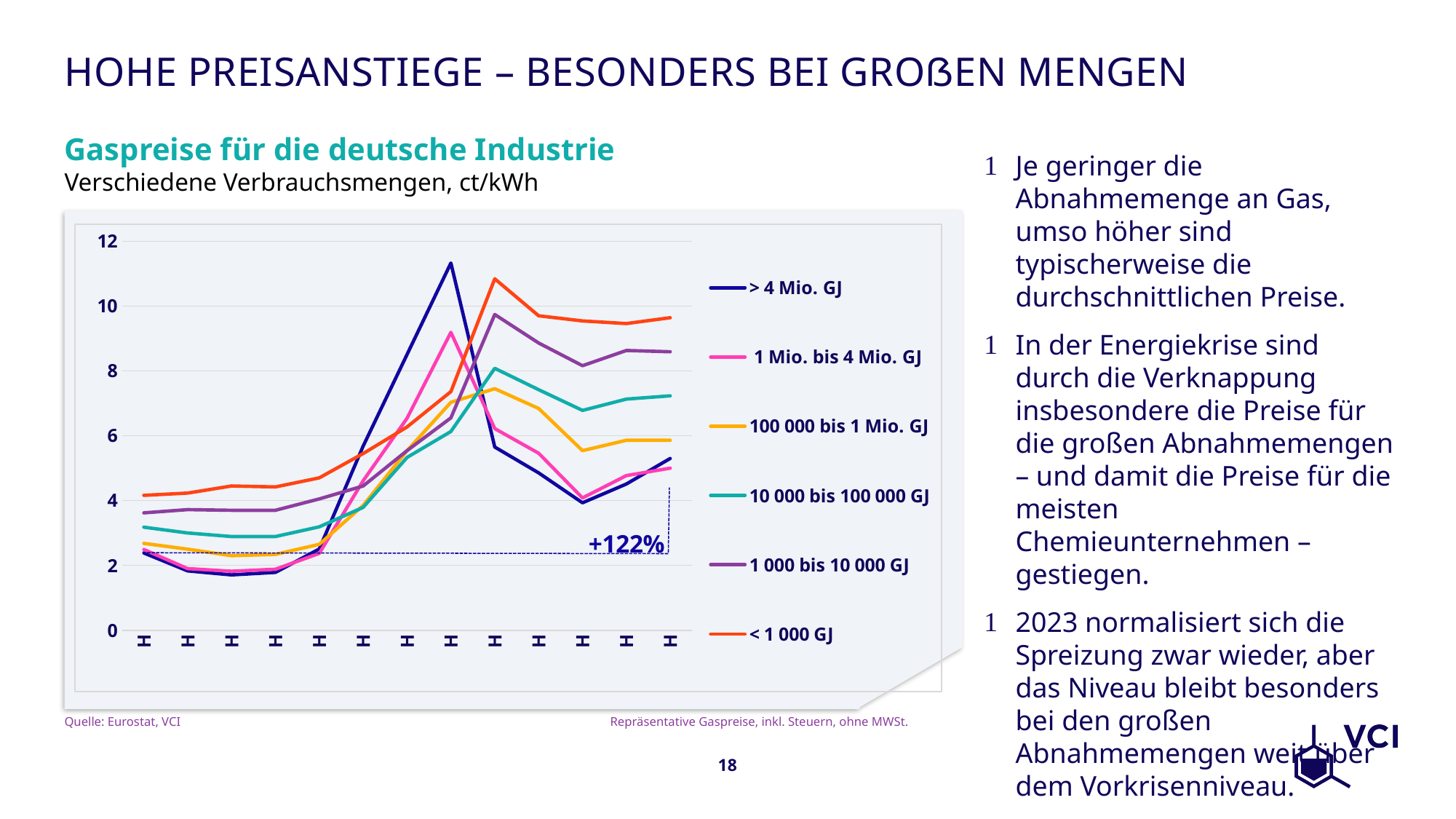
At the last point on the x axis, which is larger: the value for "< 1 000 GJ" or the value for "1 000 bis 10 000 GJ"? < 1 000 GJ Is the peak value of the "1 Mio. bis 4 Mio. GJ" series greater or less than 10? less What is the title of the chart? Gaspreise für die deutsche Industrie Which series has the highest value at the last point on the x axis? < 1 000 GJ Is the lowest value of the "> 4 Mio. GJ" series greater or less than 2? less What kind of chart is shown on the slide? line chart How many series does the legend of the chart list? 6 What percentage change is annotated on the chart? +122% In what unit are the gas prices in the chart given? ct/kWh How many data points does each line in the chart have? 13 Is the peak value of the "> 4 Mio. GJ" series greater or less than 10? greater Which series reaches the highest peak in the chart? > 4 Mio. GJ